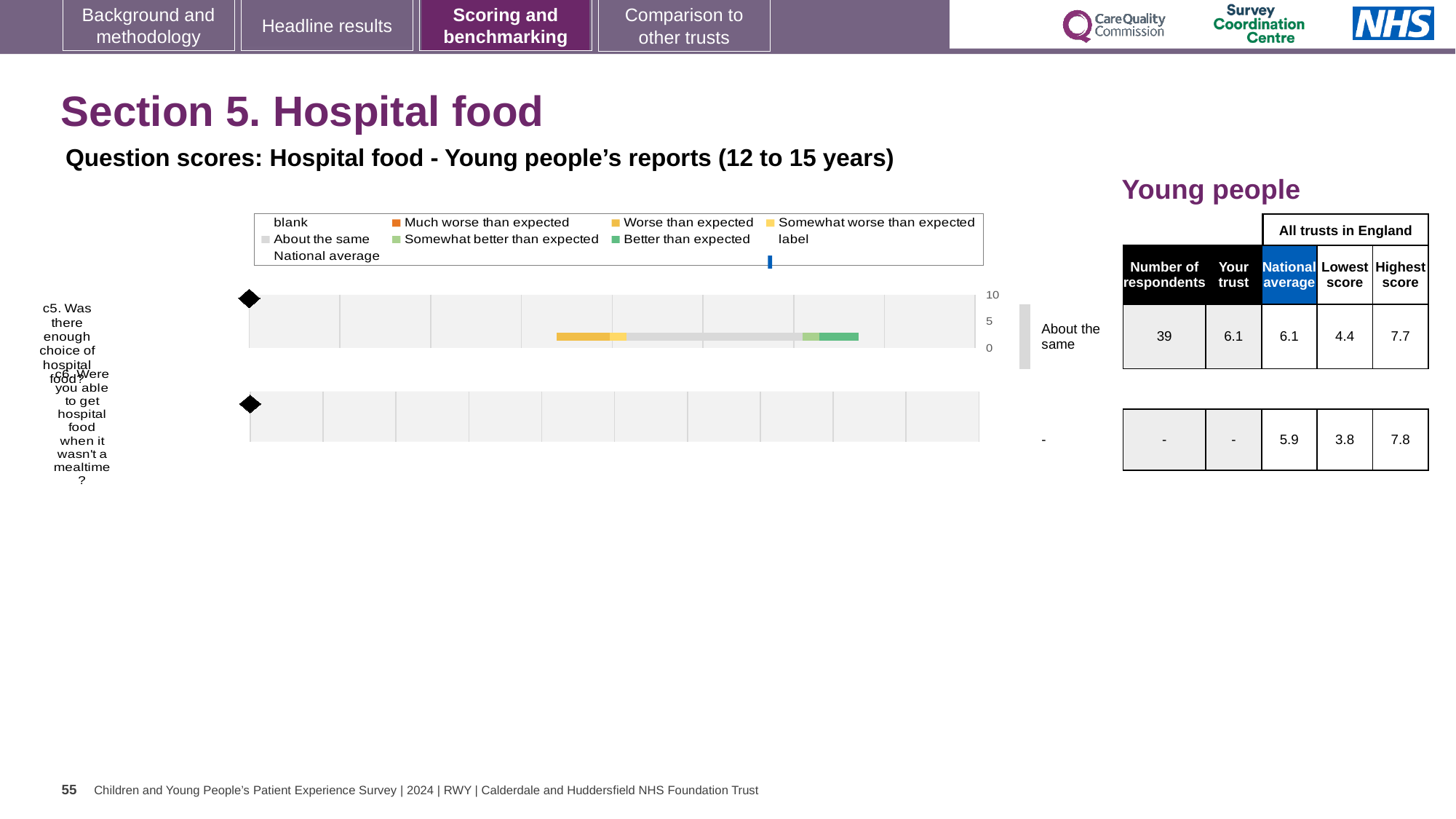
Which question has the higher national average score, c5 or c6? c5 What is the national average score for question c5 'Was there enough choice of hospital food?'? 6.1 What is the 'Your trust' score for question c5 'Was there enough choice of hospital food?'? 6.1 What is the lowest score across all trusts in England for question c5? 4.4 What is the highest score across all trusts in England for question c6 'Were you able to get hospital food when it wasn't a mealtime?'? 7.8 What is the difference between the highest and lowest scores across all trusts for question c5? 3.3 What is the maximum value shown on the score axis of the chart? 10 How is the trust's result for question c5 categorised relative to expectations? About the same How many survey questions are plotted in the hospital food chart? 2 How many respondents answered question c5 'Was there enough choice of hospital food?'? 39 Which legend colour represents 'Better than expected'? green What kind of chart is used to show the question scores for hospital food? bar chart